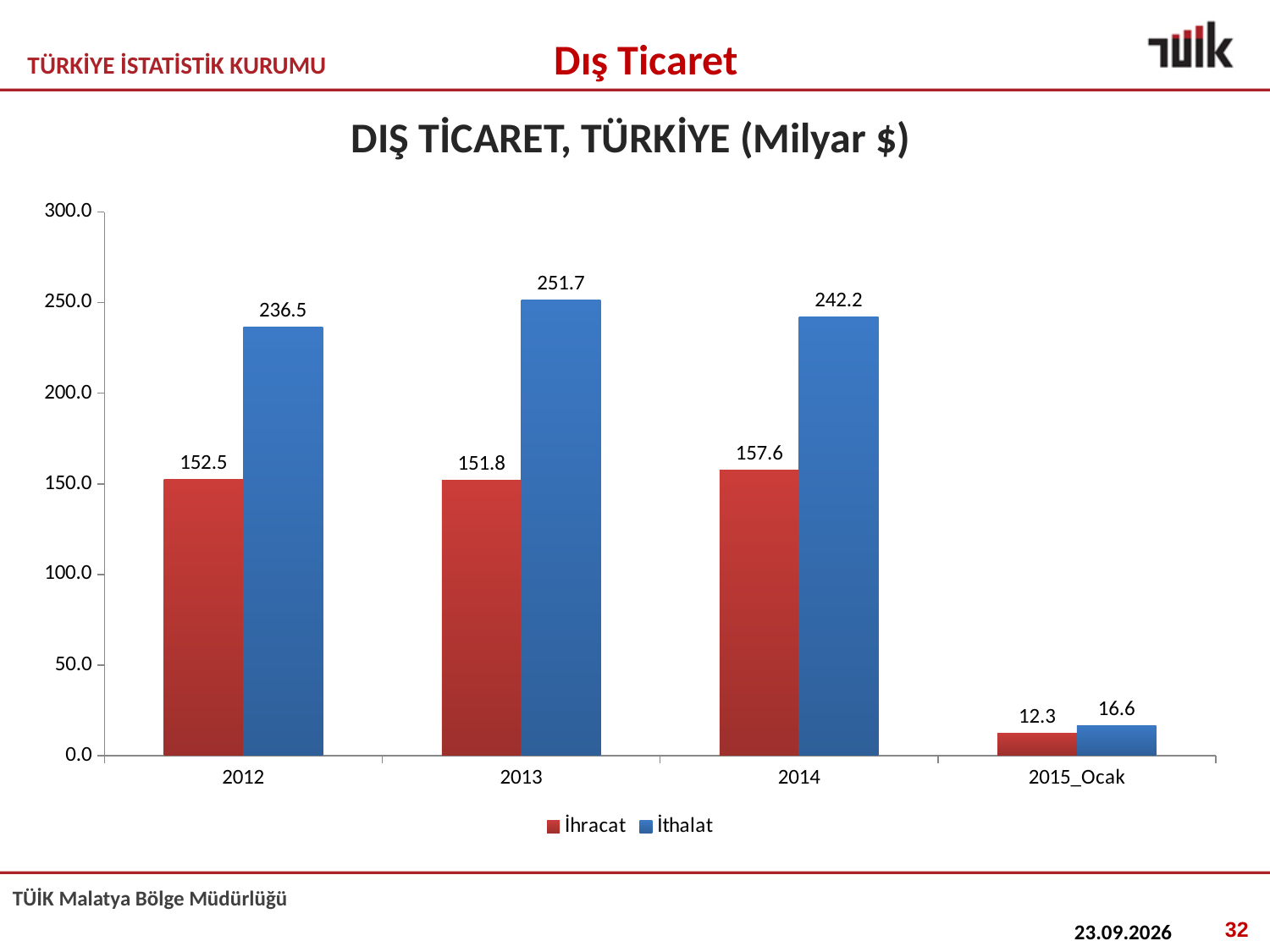
What is the difference between İthalat and İhracat in 2012? 84.0 What is the title of the chart? DIŞ TİCARET, TÜRKİYE (Milyar $) What kind of chart is shown on the slide? bar chart Which is larger, the İhracat value for 2014 or the İhracat value for 2012? 2014 Which category has the lowest İhracat value? 2015_Ocak What is the İthalat value for 2015_Ocak? 16.6 How many categories are shown on the x axis? 4 What is the İthalat value for 2014? 242.2 How many series does the legend list? 2 What is the İhracat value for 2013? 151.8 Which category has the highest İthalat value? 2013 Is the İthalat value for 2013 greater or less than 250.0? greater